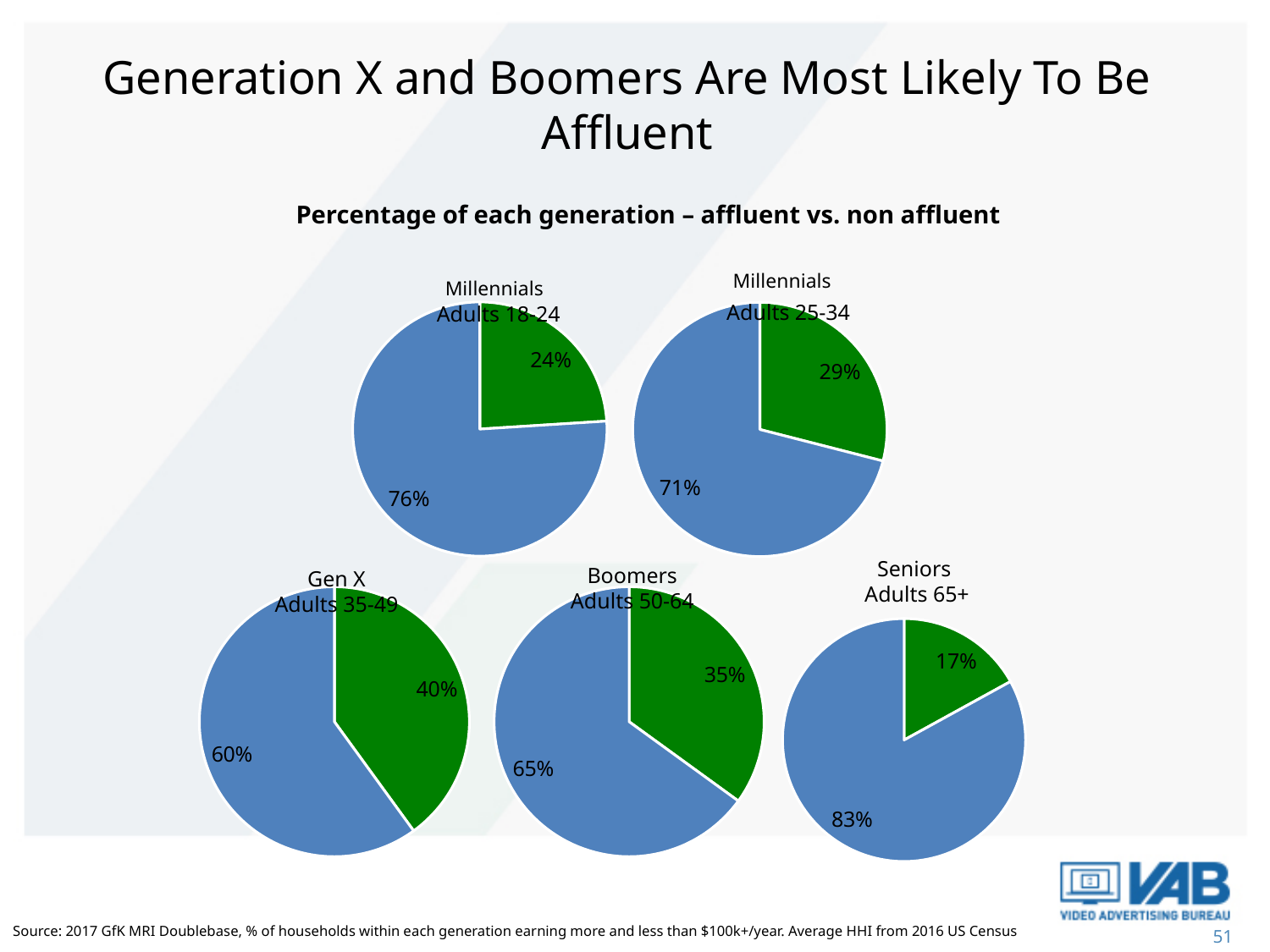
In the Millennials Adults 18-24 pie chart, what percentage does the green slice represent? 24% In the Seniors Adults 65+ pie chart, what percentage does the green slice represent? 17% In the Gen X Adults 35-49 pie chart, what percentage does the green slice represent? 40% Which is larger: the green slice in the Millennials Adults 25-34 pie chart or the green slice in the Millennials Adults 18-24 pie chart? Millennials Adults 25-34 In the Boomers Adults 50-64 pie chart, what percentage does the blue slice represent? 65% Across the five pie charts, which generation has the smallest green slice? Seniors Adults 65+ How many pie charts are shown on the slide? 5 What is the subtitle printed above the pie charts? Percentage of each generation – affluent vs. non affluent Across the five pie charts, which generation has the largest green slice? Gen X Adults 35-49 What kind of chart is used for each generation on the slide? Pie chart What is the difference between the green slice in the Gen X Adults 35-49 pie chart and the green slice in the Boomers Adults 50-64 pie chart? 5% In the Millennials Adults 25-34 pie chart, what percentage does the blue slice represent? 71%